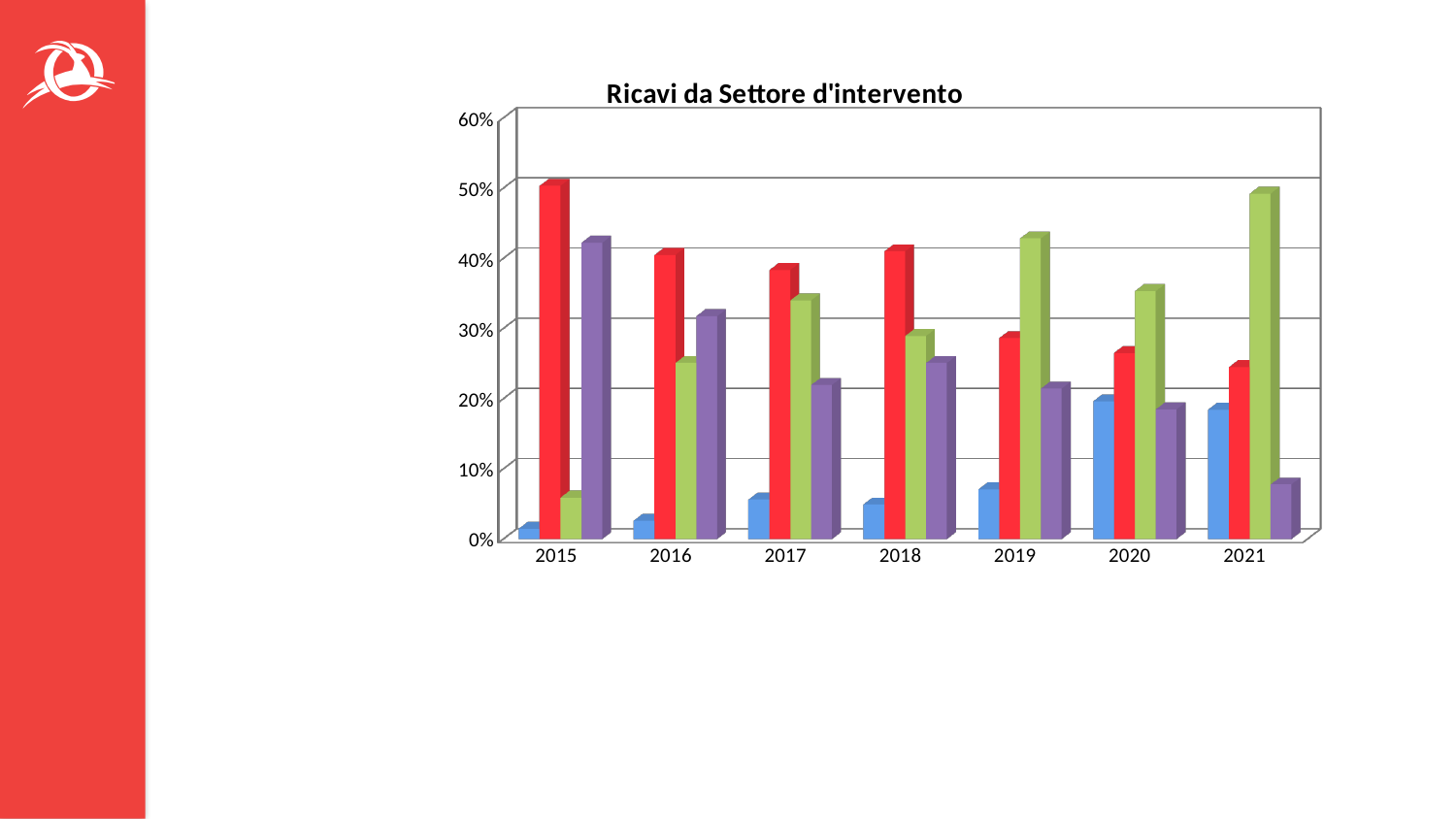
In which year is the purple bar the lowest? 2021 Does the green bar generally rise or fall from 2015 to 2021? rise What is the title of the chart? Ricavi da Settore d'intervento Is the value of the green bar for 2015 greater or less than 10%? less What kind of chart is shown on the slide? bar chart How many years are shown on the x axis of the chart? 7 In which year is the green bar the highest? 2021 Which is larger in 2019, the red bar or the green bar? the green bar Is the value of the red bar for 2015 greater or less than 40%? greater In which year is the red bar the highest? 2015 Which is larger in 2016, the red bar or the purple bar? the red bar Is the value of the purple bar for 2021 greater or less than 10%? less